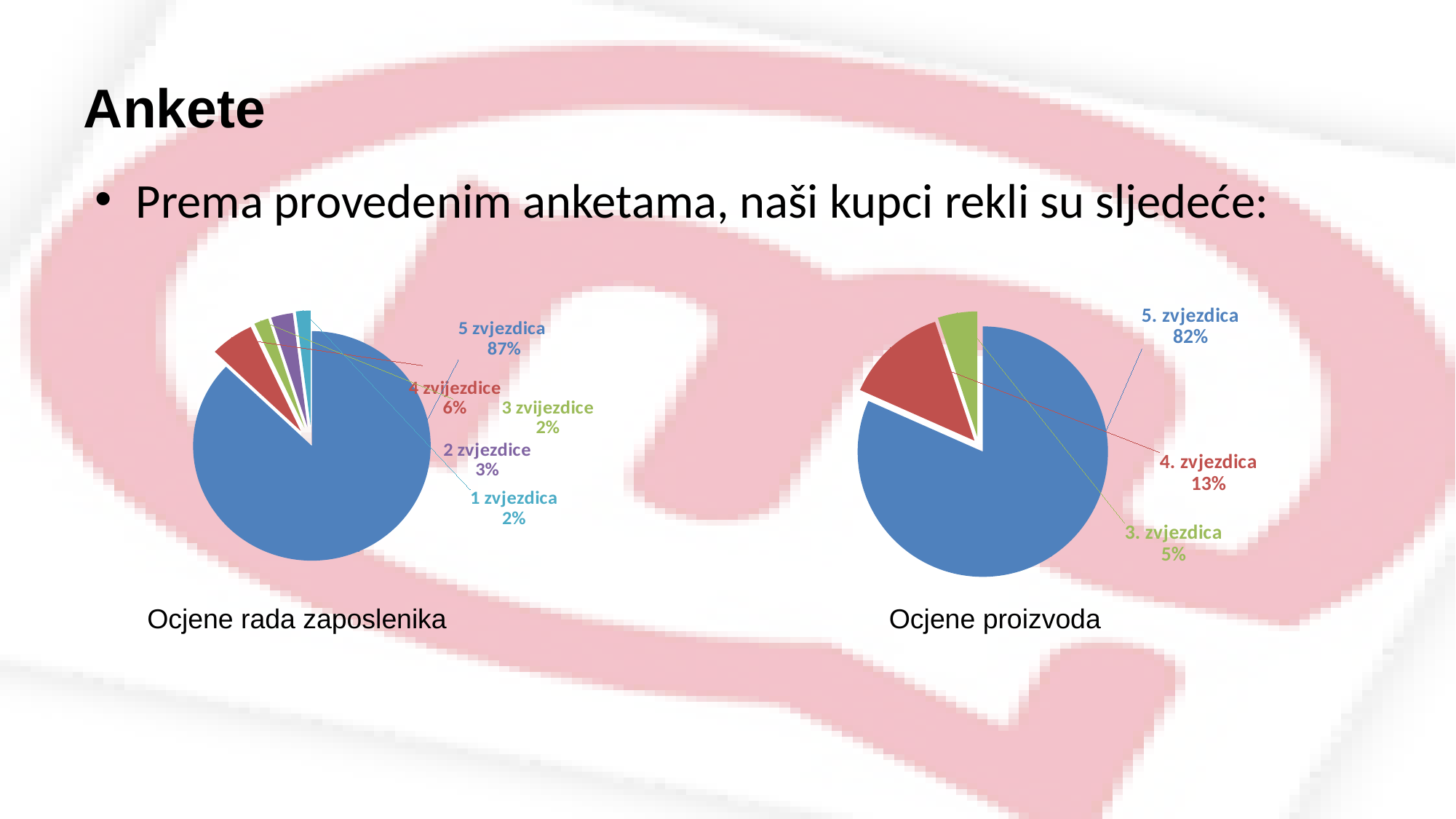
In the left chart (Ocjene rada zaposlenika), what percentage is shown for 4 zvijezdice? 6% In the right chart (Ocjene proizvoda), what is the difference between the 4. zvjezdica share and the 3. zvjezdica share? 8% In the left chart (Ocjene rada zaposlenika), how many slices does the pie have? 5 In the right chart (Ocjene proizvoda), how many slices does the pie have? 3 In the right chart (Ocjene proizvoda), what share of the pie is labelled 5. zvjezdica? 82% In the right chart (Ocjene proizvoda), what percentage is shown for 4. zvjezdica? 13% In the left chart (Ocjene rada zaposlenika), what share of the pie is labelled 5 zvjezdica? 87% What type of chart is used for Ocjene proizvoda? Pie chart In the left chart (Ocjene rada zaposlenika), which category has the largest slice? 5 zvjezdica In the left chart (Ocjene rada zaposlenika), what is the difference between the 4 zvijezdice share and the 2 zvjezdice share? 3% In the left chart (Ocjene rada zaposlenika), what percentage is shown for 2 zvjezdice? 3% In the right chart (Ocjene proizvoda), which category has the smallest slice? 3. zvjezdica